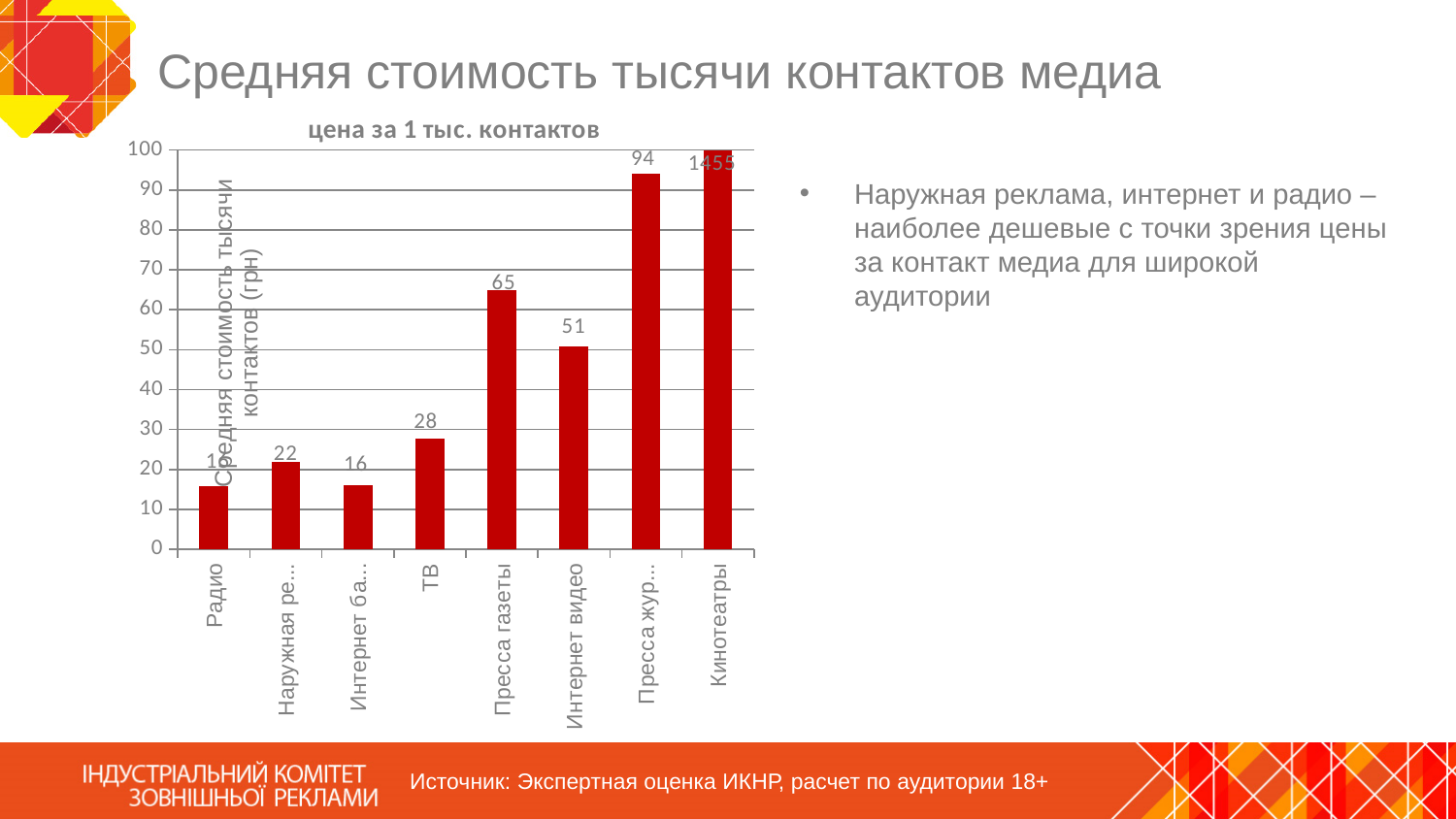
What is the title of the chart? цена за 1 тыс. контактов Is the value for Радио greater or less than 20? less What type of chart is shown on the slide? bar chart Which category has the highest value? Кинотеатры What is the value for Пресса газеты? 65 How many categories are plotted on the chart? 8 What is the difference between the values for Пресса газеты and Интернет видео? 14 Which is larger, the value for ТВ or the value for Интернет видео? Интернет видео What is the value for Кинотеатры? 1455 What is the value for Интернет видео? 51 What is the difference between the values for Пресса газеты and ТВ? 37 What is the value for ТВ? 28